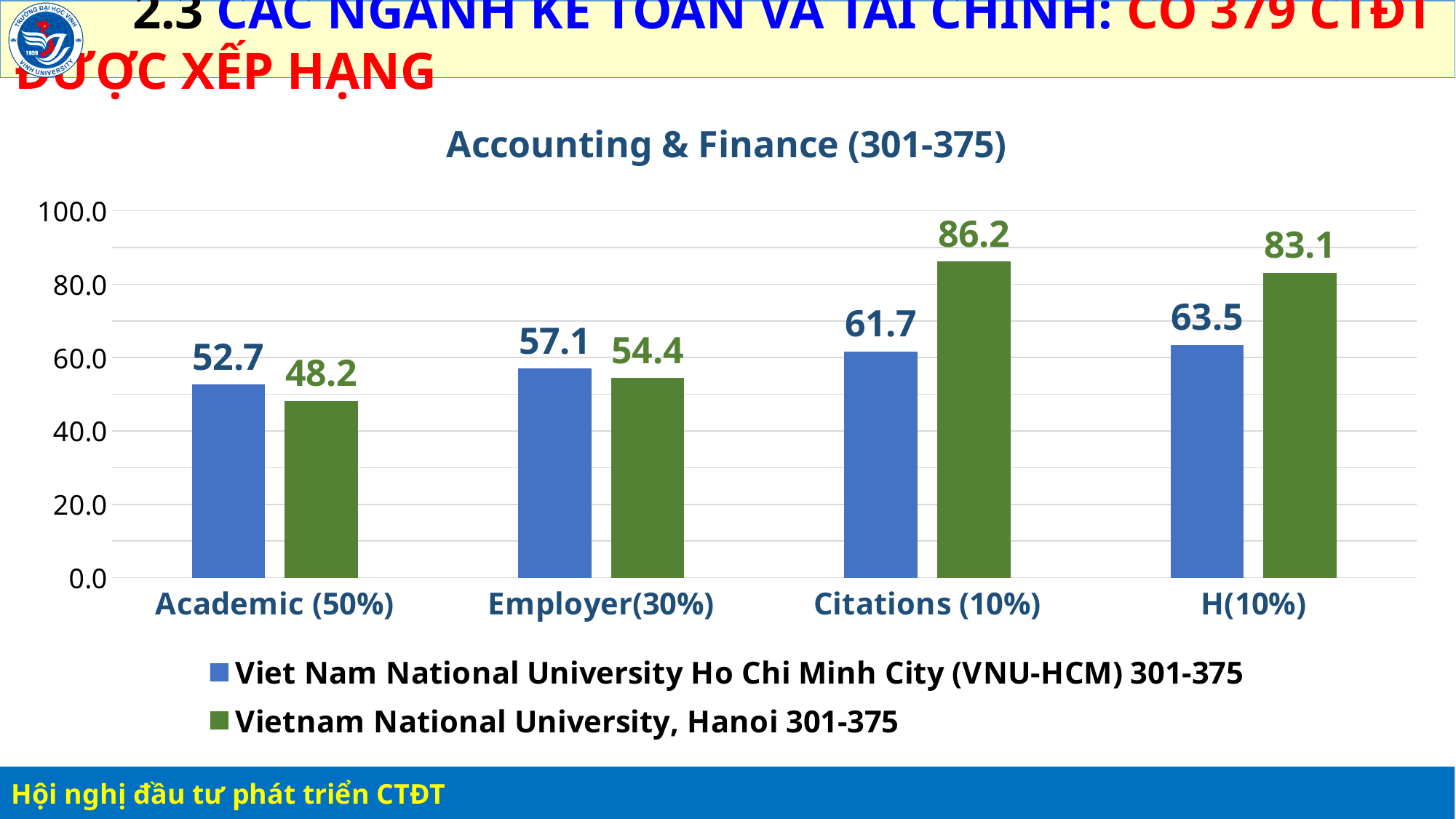
What is the value for Viet Nam National University Ho Chi Minh City (VNU-HCM) in the Academic (50%) category? 52.7 What is the value for Viet Nam National University Ho Chi Minh City (VNU-HCM) in the Employer(30%) category? 57.1 How many categories are shown on the x axis? 4 In which category does Vietnam National University, Hanoi have its highest value? Citations (10%) Which university has the larger value in the Employer(30%) category? Viet Nam National University Ho Chi Minh City (VNU-HCM) What is the difference between the two universities' values in the Citations (10%) category? 24.5 In which category does Viet Nam National University Ho Chi Minh City (VNU-HCM) have its lowest value? Academic (50%) How many series does the legend list? 2 What is the value for Vietnam National University, Hanoi in the H(10%) category? 83.1 Is the value for Vietnam National University, Hanoi in the Academic (50%) category greater or less than 60.0? less What type of chart is shown on the slide? Bar chart What is the value for Vietnam National University, Hanoi in the Citations (10%) category? 86.2